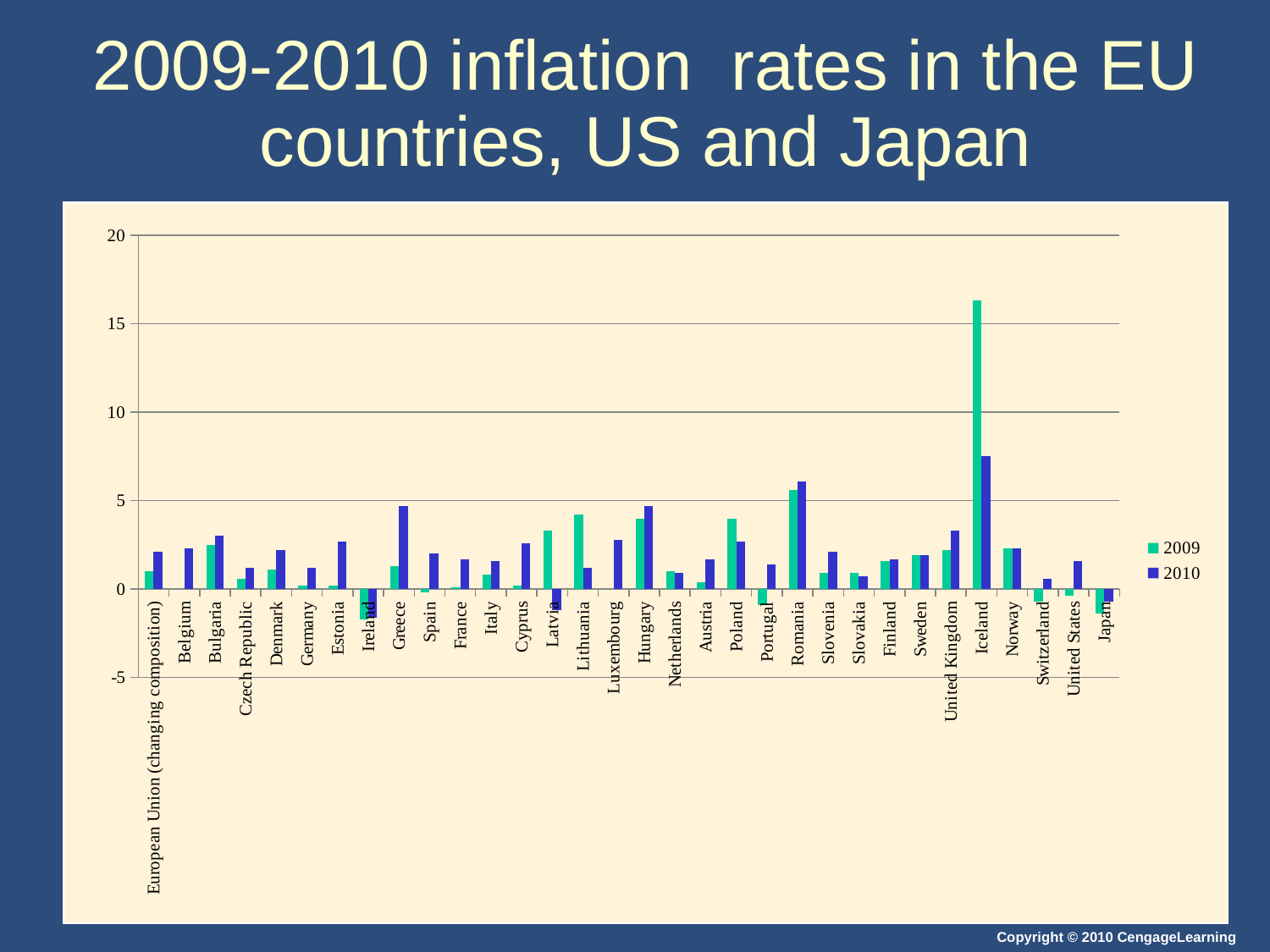
Is the 2010 value for Greece greater or less than 5? less Is the 2009 value for Ireland greater or less than 0? less Is the 2009 value for Iceland greater or less than 15? greater How many countries/categories are plotted along the x axis? 32 What kind of chart is shown on the slide? bar chart Which category has the highest 2010 inflation rate? Iceland Which colour represents the 2010 series in the legend? blue For Greece, which year has the larger inflation rate, 2009 or 2010? 2010 Which category has the highest 2009 inflation rate? Iceland For Iceland, which year has the larger inflation rate, 2009 or 2010? 2009 How many series does the legend list? 2